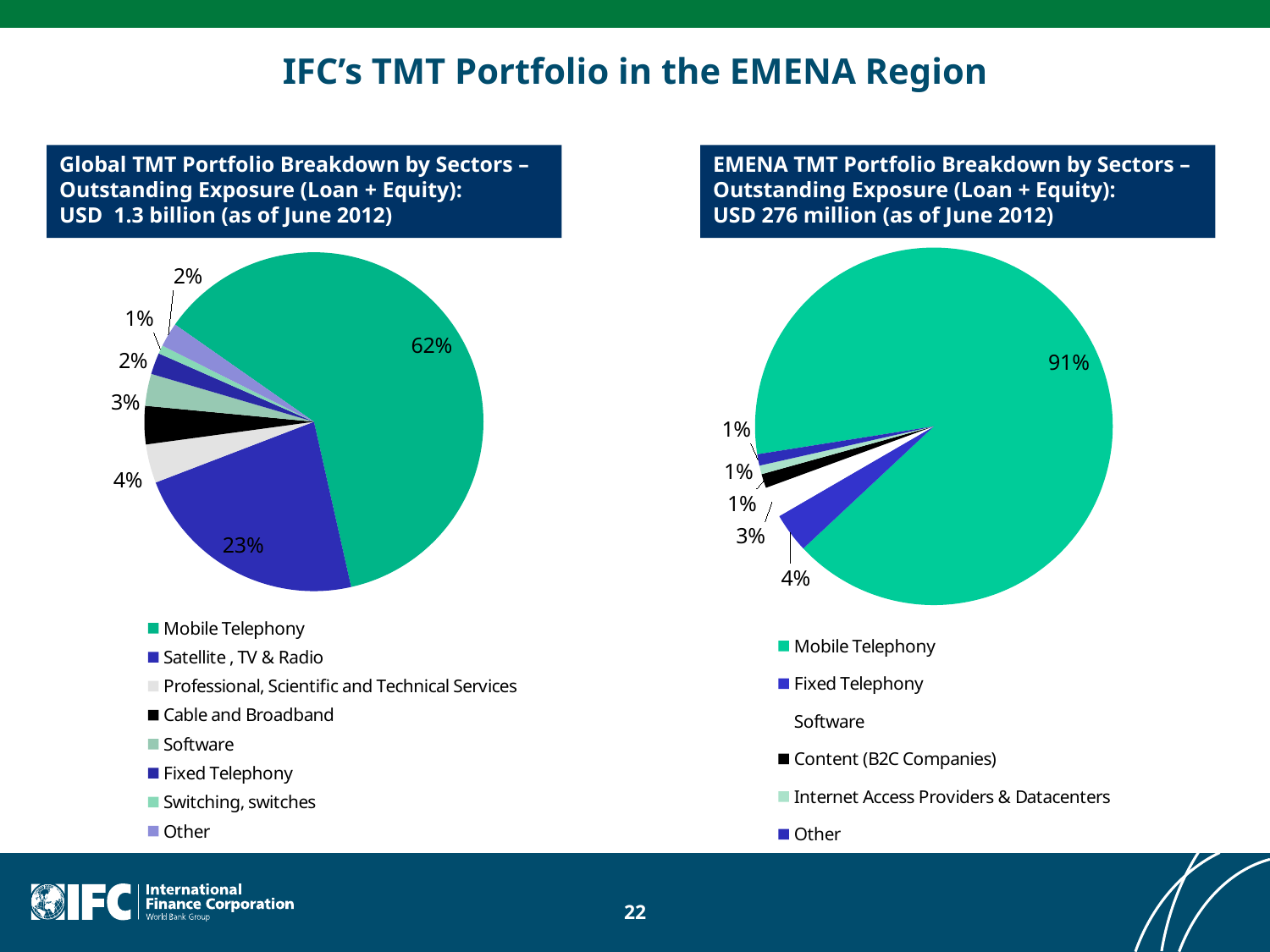
In the Global TMT Portfolio pie chart, what share does Satellite, TV & Radio hold? 23% How many sectors does the legend of the Global TMT Portfolio pie chart list? 8 What type of chart is used for the EMENA TMT Portfolio breakdown? Pie chart In the EMENA TMT Portfolio pie chart, what share does Software hold? 3% In the Global TMT Portfolio pie chart, what share does Mobile Telephony hold? 62% In the Global TMT Portfolio pie chart, what is the difference between the Mobile Telephony share and the Satellite, TV & Radio share? 39% In the Global TMT Portfolio pie chart, what share does Professional, Scientific and Technical Services hold? 4% How many sectors does the legend of the EMENA TMT Portfolio pie chart list? 6 In the EMENA TMT Portfolio pie chart, what share does Mobile Telephony hold? 91% In the Global TMT Portfolio pie chart, which sector has the largest share? Mobile Telephony In the EMENA TMT Portfolio pie chart, what share does Fixed Telephony hold? 4%